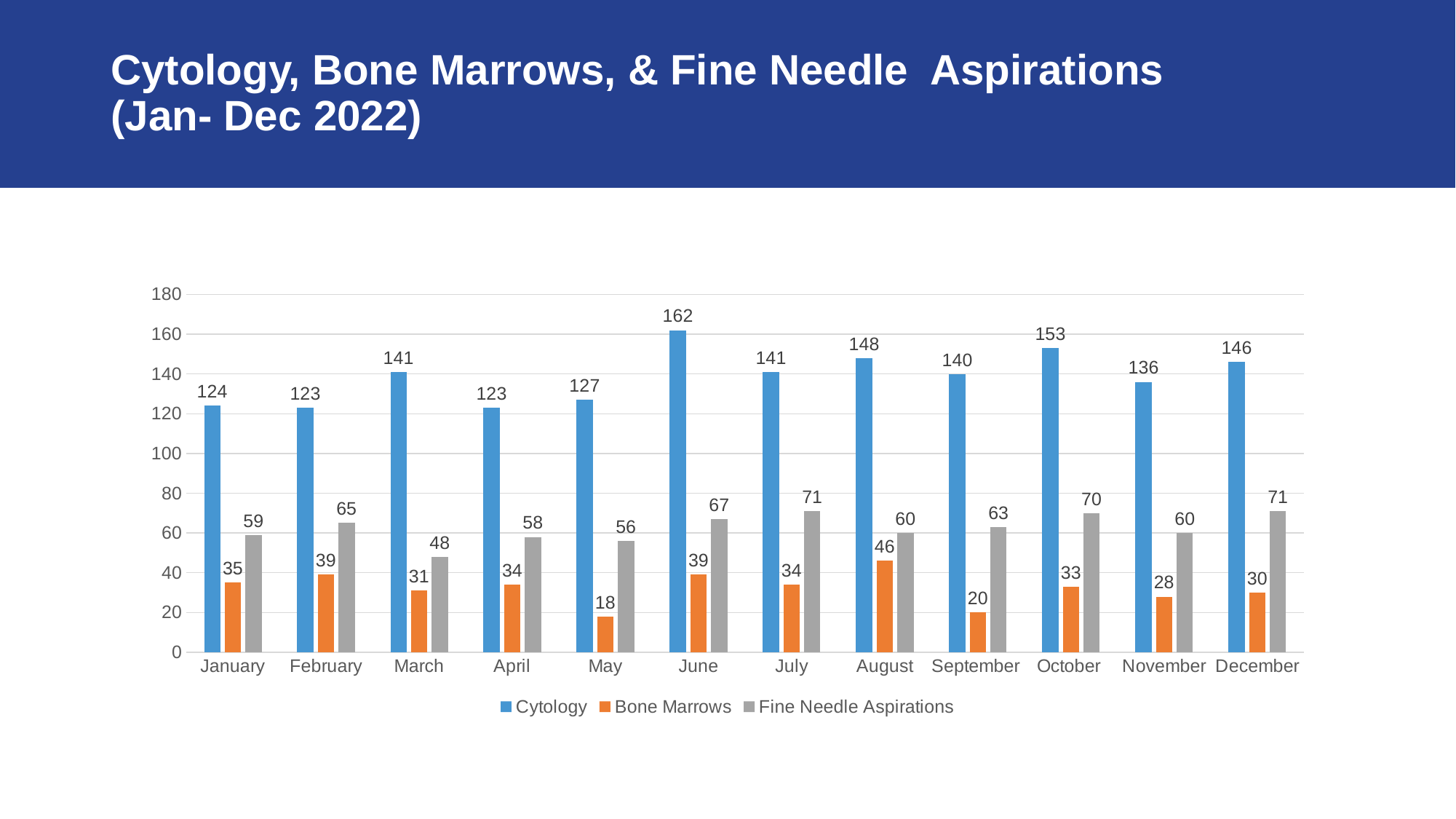
How many months are shown on the x axis? 12 Which month has the highest Cytology value? June How many series does the legend list? 3 What is the difference between the Cytology values for June and January? 38 Which series is shown in orange in the legend? Bone Marrows Is the Cytology value for October greater or less than 140? greater What is the Fine Needle Aspirations value for October? 70 What kind of chart is shown on the slide? Bar chart What is the Bone Marrows value for May? 18 Which is larger, the Fine Needle Aspirations value for March or for April? April Which month has the lowest Bone Marrows value? May What is the Cytology value for June? 162